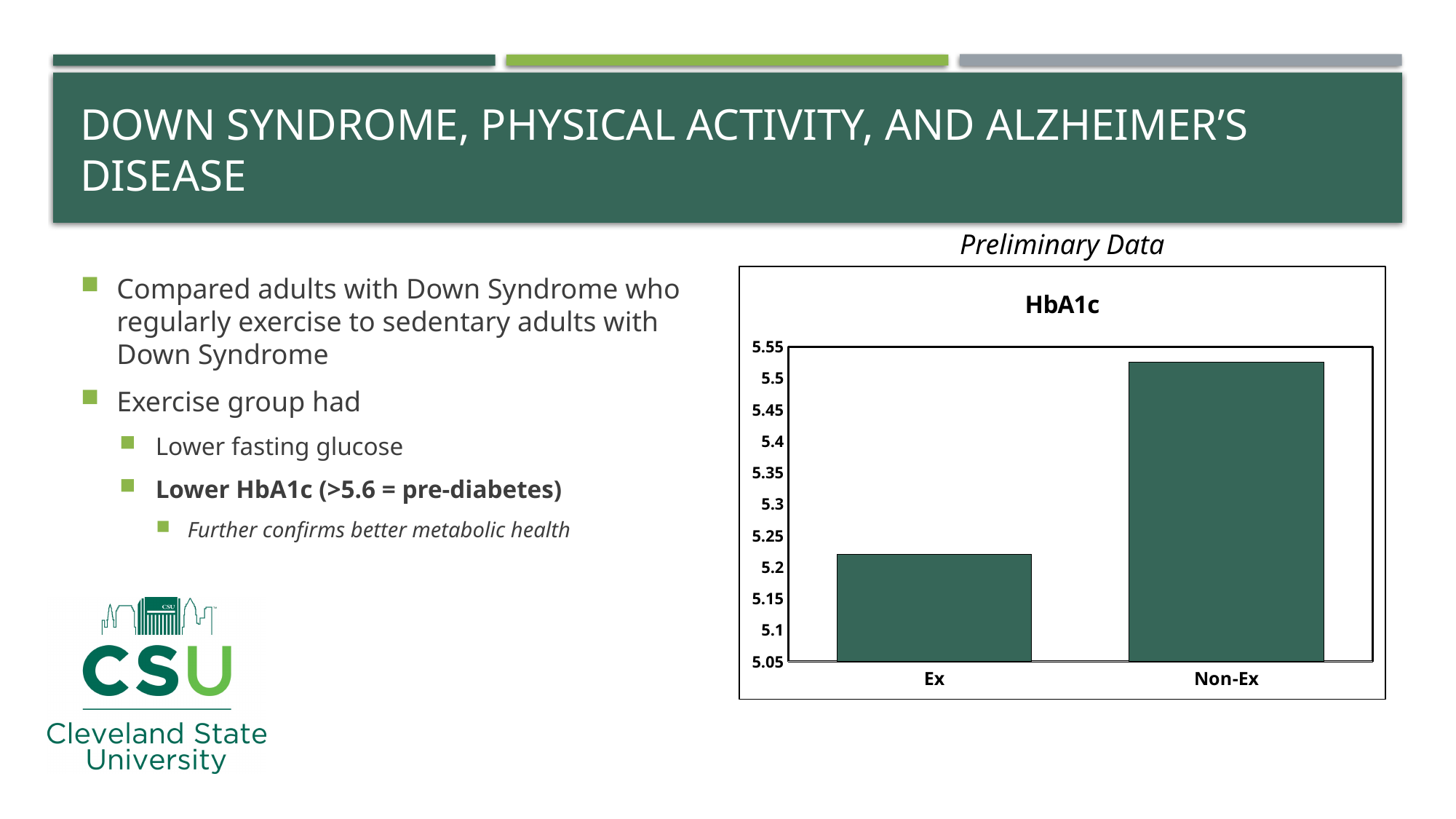
What is the lowest value shown on the y axis of the HbA1c chart? 5.05 Is the HbA1c value for Ex greater or less than 5.15? greater Is the HbA1c value for Ex greater or less than 5.3? less Do the HbA1c values rise or fall from Ex to Non-Ex? rise What is the title of the chart? HbA1c Which category has the lowest HbA1c value? Ex Is the HbA1c value for Non-Ex greater or less than 5.55? less Which has a larger HbA1c value, Ex or Non-Ex? Non-Ex Which category has the highest HbA1c value? Non-Ex How many categories are shown on the x axis of the HbA1c chart? 2 What kind of chart is shown on the slide? bar chart